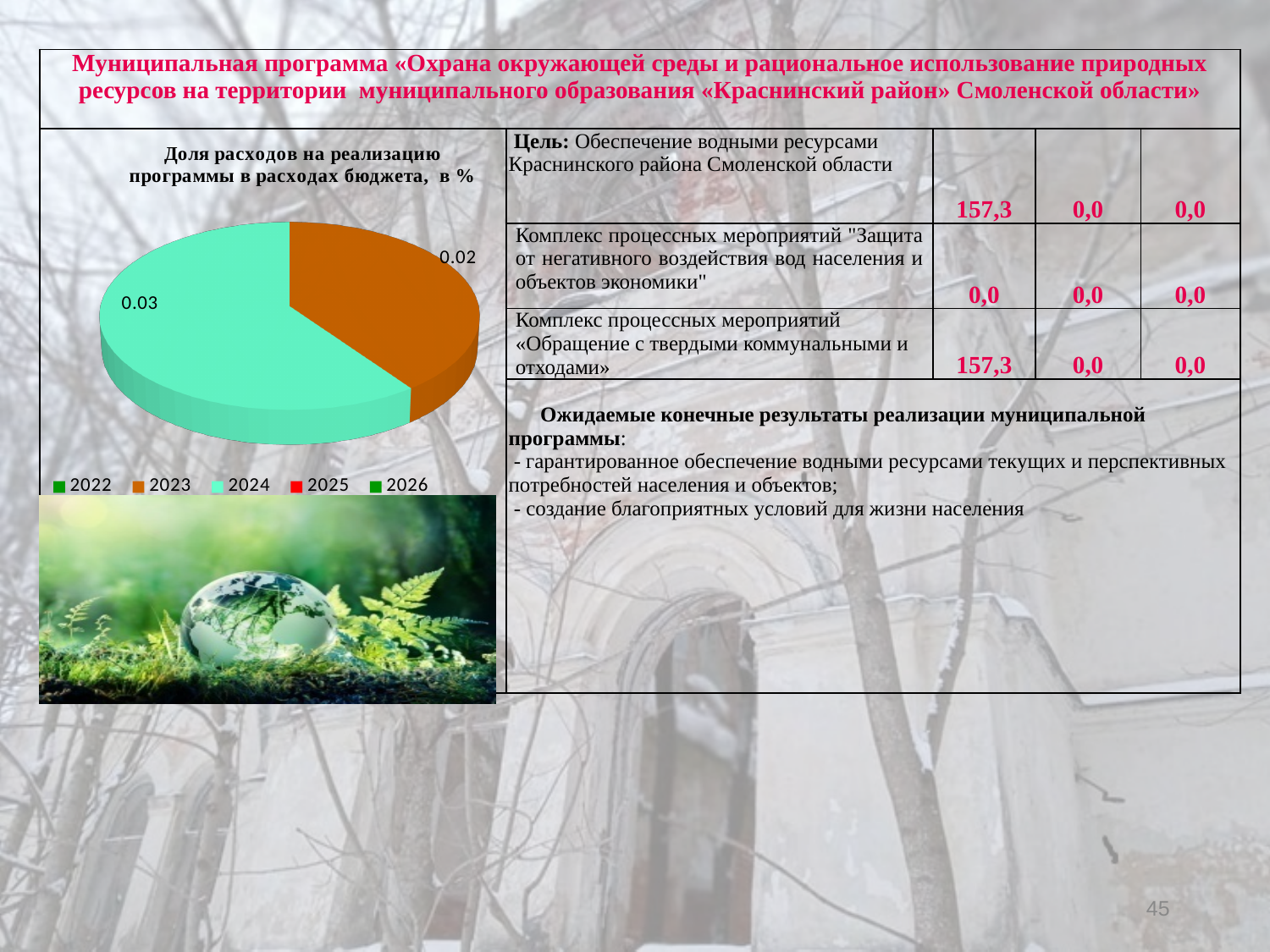
How many slices with data labels are visible in the pie chart? 2 What kind of chart is shown on the slide? pie chart What value is shown for 2024 in the pie chart? 0.03 What value is shown for 2023 in the pie chart? 0.02 What is the difference between the values for 2024 and 2023 in the pie chart? 0.01 Which year has the largest slice in the pie chart? 2024 How many entries does the legend of the pie chart list? 5 What colour is the slice for 2023 in the pie chart? orange What is the title of the pie chart? Доля расходов на реализацию программы в расходах бюджета, в % Which is larger in the pie chart, the value for 2023 or the value for 2024? 2024